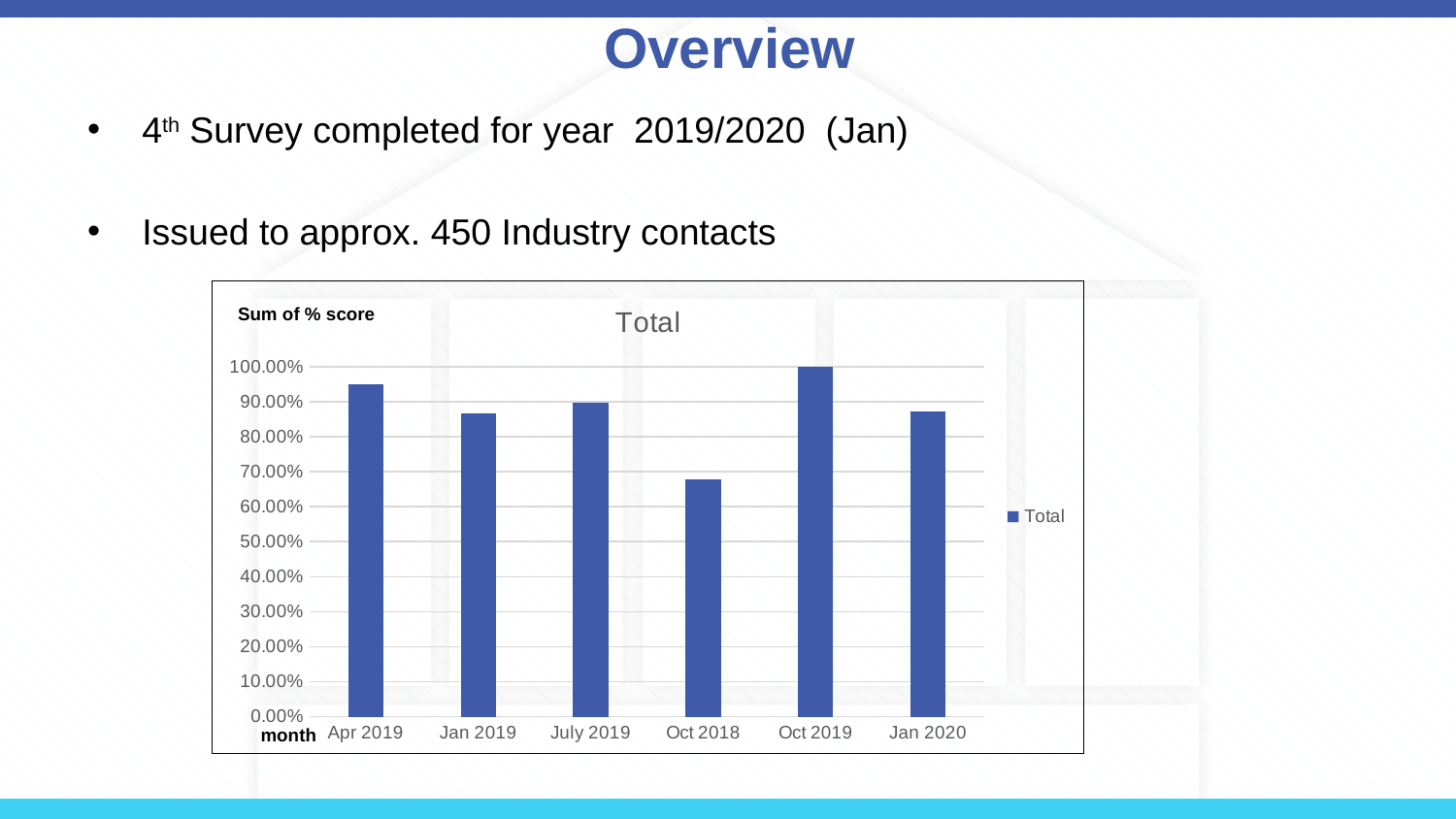
What is the value for Oct 2019 in the chart? 100.00% What is the title of the chart? Total What label is shown on the x axis of the chart? month Is the value for Jan 2020 greater or less than 90.00%? less Is the value for Apr 2019 greater or less than 90.00%? greater Is the value for Oct 2018 greater or less than 70.00%? less Which month has the lowest value in the chart? Oct 2018 What type of chart is shown on the slide? bar chart Which month has the highest value in the chart? Oct 2019 How many series does the chart's legend list? 1 Which is larger, the value for Apr 2019 or the value for Oct 2018? Apr 2019 How many months are shown on the x axis of the chart? 6